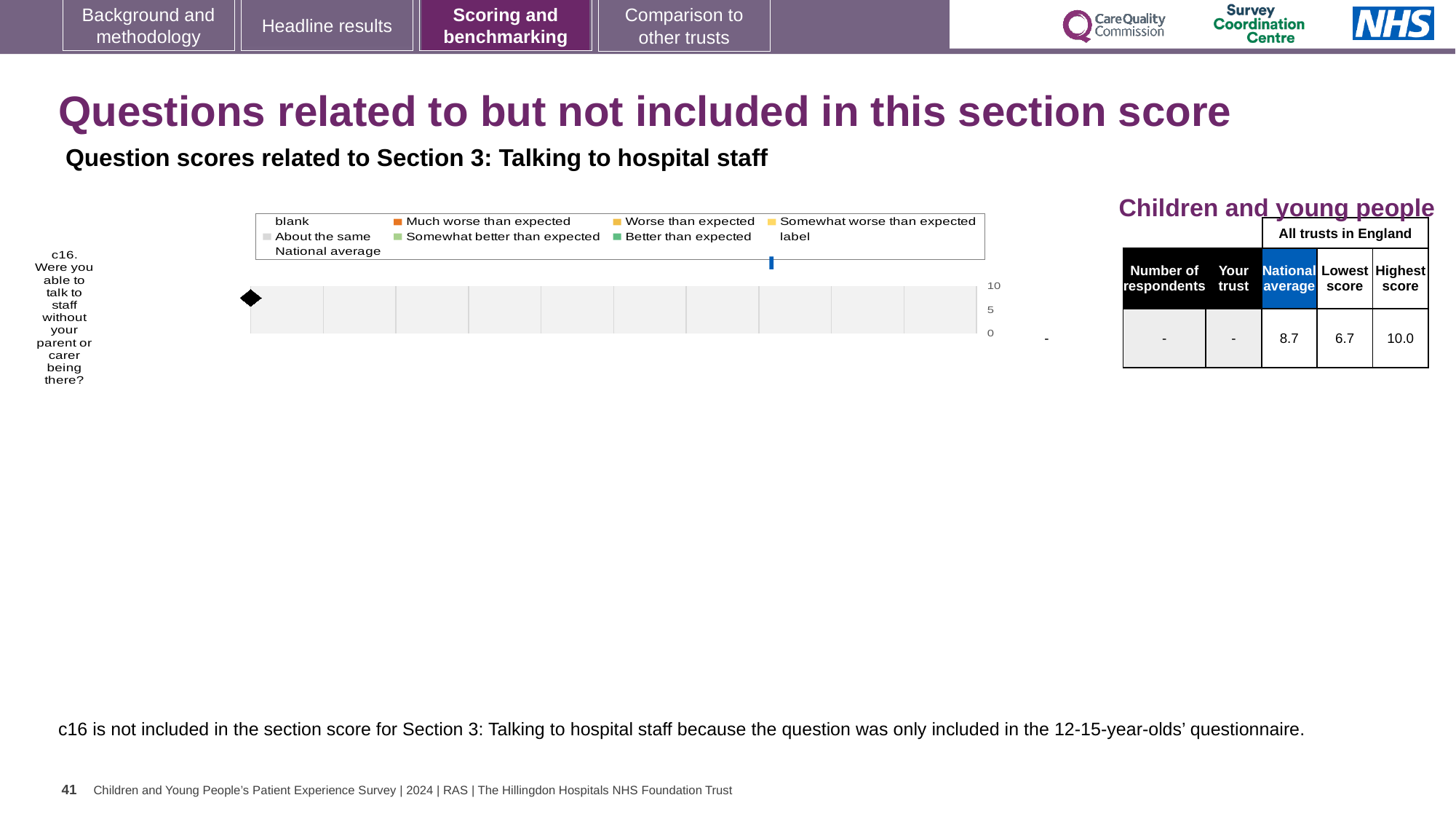
What kind of chart is shown for question c16? bar chart What is the highest value shown on the chart's horizontal axis? 10 In the table next to the chart, what is the National average score for c16? 8.7 In the table next to the chart, what is the difference between the Highest score and the Lowest score for c16? 3.3 Which legend entry is shown with an orange marker? Much worse than expected In the table next to the chart, is the National average for c16 greater or less than 5? greater How many question categories are plotted on the chart's vertical axis? 1 In the table next to the chart, what is the Highest score across all trusts in England for c16? 10.0 In the table next to the chart, what is the Lowest score across all trusts in England for c16? 6.7